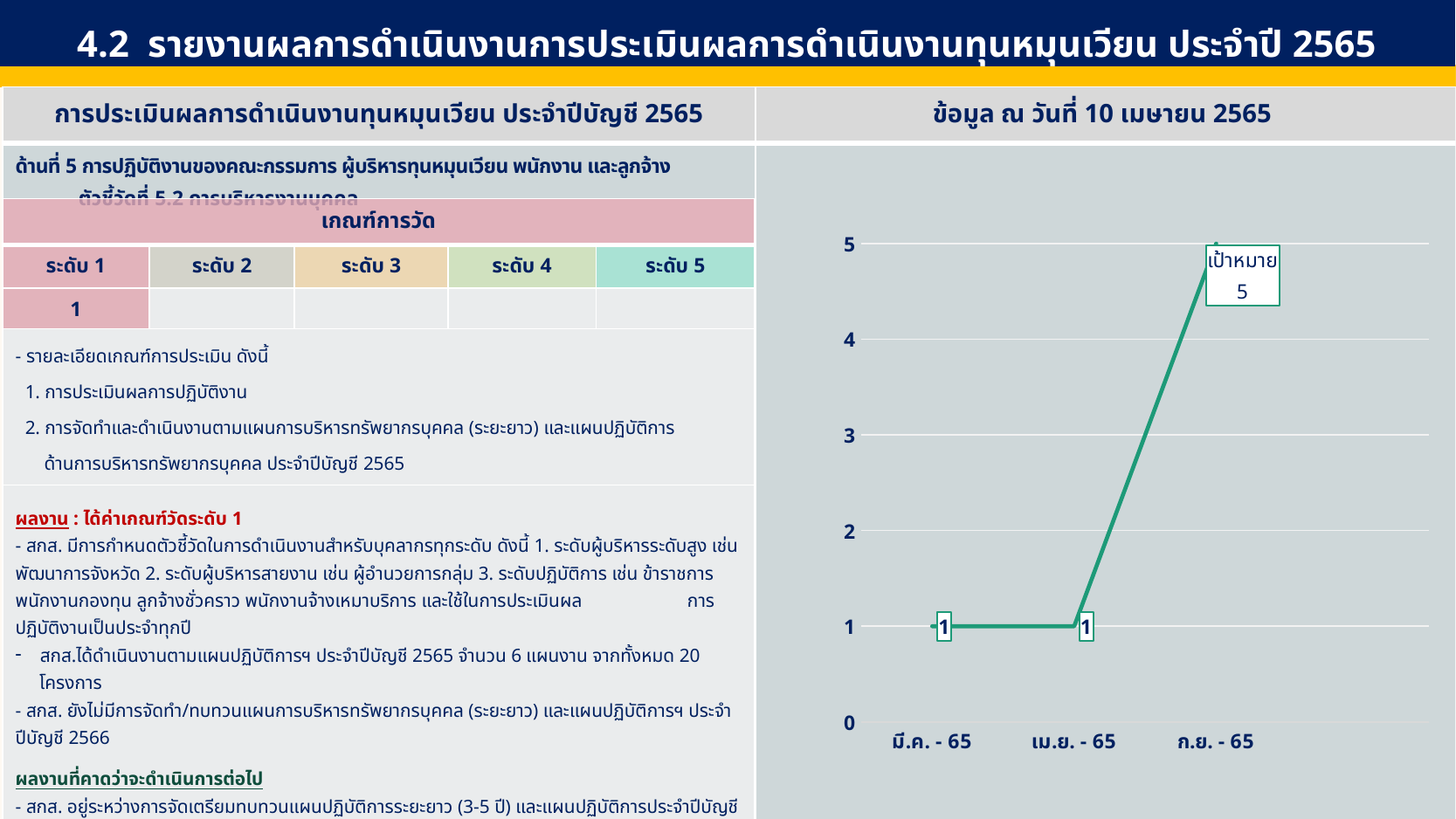
Do the plotted values rise or fall from มี.ค. - 65 to ก.ย. - 65? rise What is the difference between the value for ก.ย. - 65 and the value for เม.ย. - 65? 4 Is the value for ก.ย. - 65 greater or less than 3? greater What is the highest value shown on the y axis of the chart? 5 Which is larger, the value for ก.ย. - 65 or the value for มี.ค. - 65? ก.ย. - 65 What is the value plotted for มี.ค. - 65? 1 What kind of chart is shown on the right side of the slide? line chart Which category on the x axis has the highest value? ก.ย. - 65 How many categories are shown on the x axis of the chart? 3 What is the value plotted for เม.ย. - 65? 1 What label is shown in the box next to the point for ก.ย. - 65? เป้าหมาย 5 What is the value plotted for ก.ย. - 65? 5